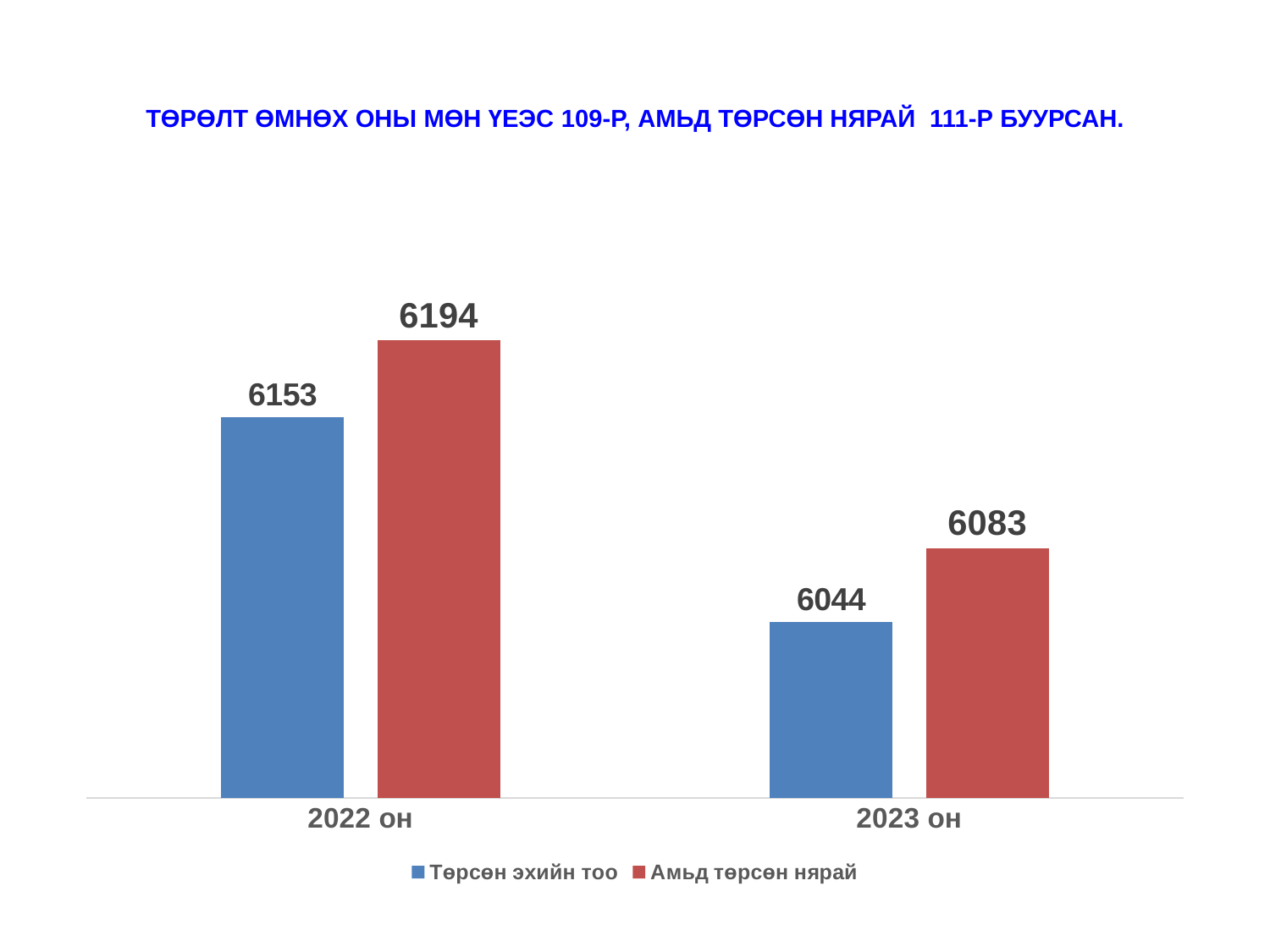
Which is larger in 2023 он: Төрсөн эхийн тоо or Амьд төрсөн нярай? Амьд төрсөн нярай What is the difference between Амьд төрсөн нярай in 2022 он and in 2023 он? 111 Which bar has the highest value on the chart? Амьд төрсөн нярай, 2022 он Does Төрсөн эхийн тоо rise or fall from 2022 он to 2023 он? Fall What is the value of Амьд төрсөн нярай for 2022 он? 6194 What kind of chart is shown on the slide? Bar chart Which bar has the lowest value on the chart? Төрсөн эхийн тоо, 2023 он How many series does the legend list? 2 What is the value of Амьд төрсөн нярай for 2023 он? 6083 What is the value of Төрсөн эхийн тоо for 2022 он? 6153 What is the value of Төрсөн эхийн тоо for 2023 он? 6044 What is the difference between Төрсөн эхийн тоо in 2022 он and in 2023 он? 109